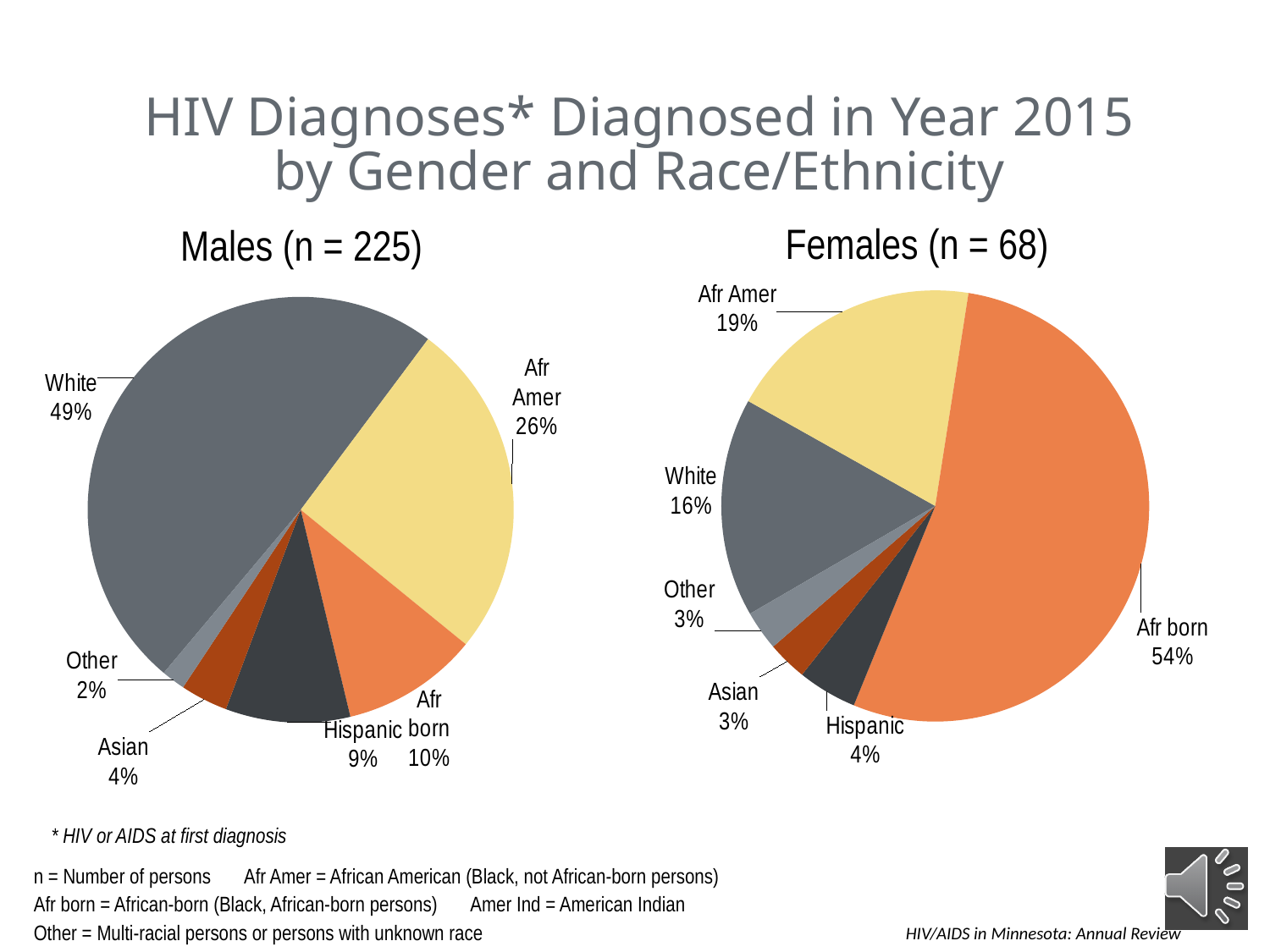
What is the title of the slide containing the two pie charts? HIV Diagnoses* Diagnosed in Year 2015 by Gender and Race/Ethnicity In the Males (n = 225) pie chart, which category has the largest share? White In the Males (n = 225) pie chart, what percentage is shown for White? 49% In the Females (n = 68) pie chart, what percentage is shown for Afr born? 54% What type of chart is used for the Males (n = 225) data? Pie chart How many categories are shown in the Females (n = 68) pie chart? 6 In the Males (n = 225) pie chart, what percentage is shown for Hispanic? 9% In the Males (n = 225) pie chart, which category has the smallest share? Other In the Females (n = 68) pie chart, what percentage is shown for Afr Amer? 19% In the Males (n = 225) pie chart, what is the difference in percentage points between White and Afr Amer? 23 In the Females (n = 68) pie chart, which category has the largest share? Afr born In the Females (n = 68) pie chart, which is larger, the share for White or the share for Afr Amer? Afr Amer